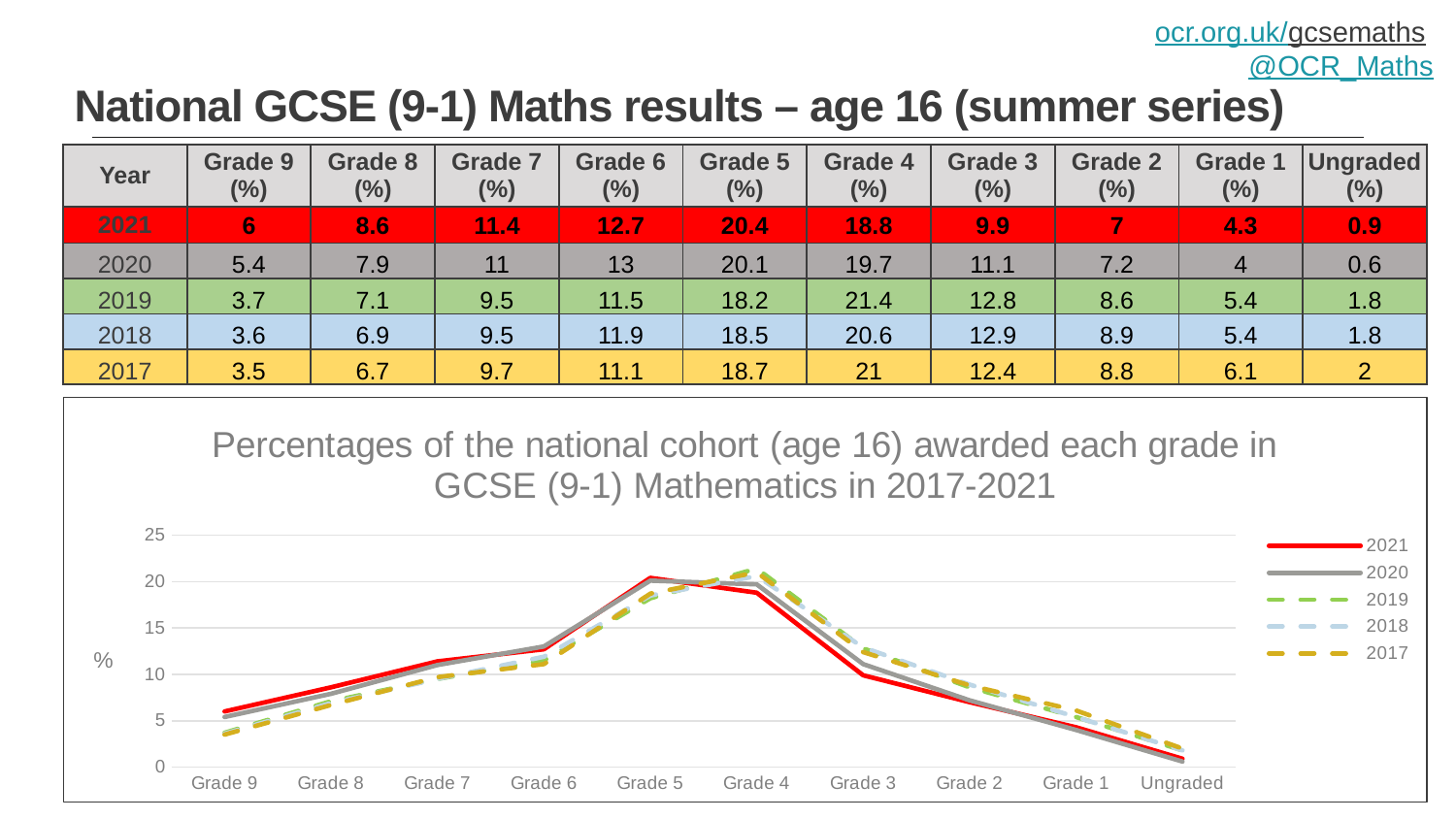
What is the difference between the Grade 9 percentage in 2021 and in 2017? 2.5 What colour is the line for the 2021 series? red For the 2021 series, which grade has the lowest percentage? Ungraded Is the 2021 value for Grade 5 greater or less than 20? greater Which year has the larger percentage for Grade 4, 2019 or 2021? 2019 Do the 2021 values rise or fall from Grade 5 to Ungraded along the x axis? fall For the 2021 series, which grade has the highest percentage? Grade 5 How many grade categories are plotted along the x axis of the chart? 10 Is the 2019 value for Grade 9 greater or less than 5? less What percentage of the cohort was awarded Grade 5 in 2021? 20.4 How many series does the chart legend list? 5 What kind of chart is shown on the slide? line chart